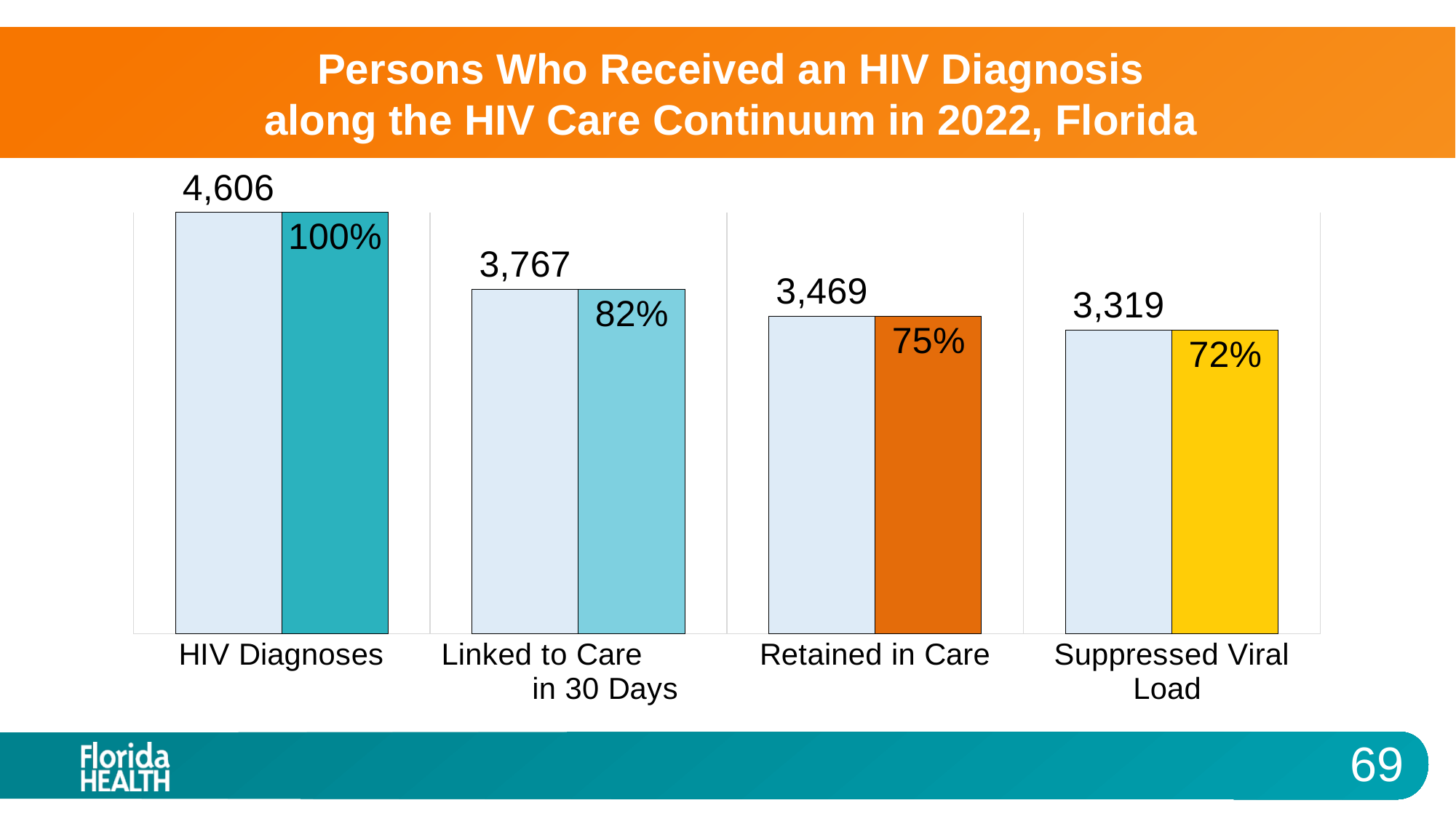
What is the difference in the number of persons between HIV Diagnoses and Linked to Care in 30 Days? 839 Do the number of persons rise or fall moving from HIV Diagnoses to Suppressed Viral Load? Fall How many stages of the care continuum are shown on the chart? 4 What is the difference in percentage points between Retained in Care and Suppressed Viral Load? 3 What percentage is shown for Suppressed Viral Load? 72% What percentage is shown for Linked to Care in 30 Days? 82% Which stage of the care continuum has the lowest number of persons? Suppressed Viral Load What kind of chart is shown on the slide? Bar chart How many persons are shown for Retained in Care? 3,469 How many persons are shown for HIV Diagnoses? 4,606 Which has more persons, Retained in Care or Suppressed Viral Load? Retained in Care Which stage of the care continuum has the highest number of persons? HIV Diagnoses